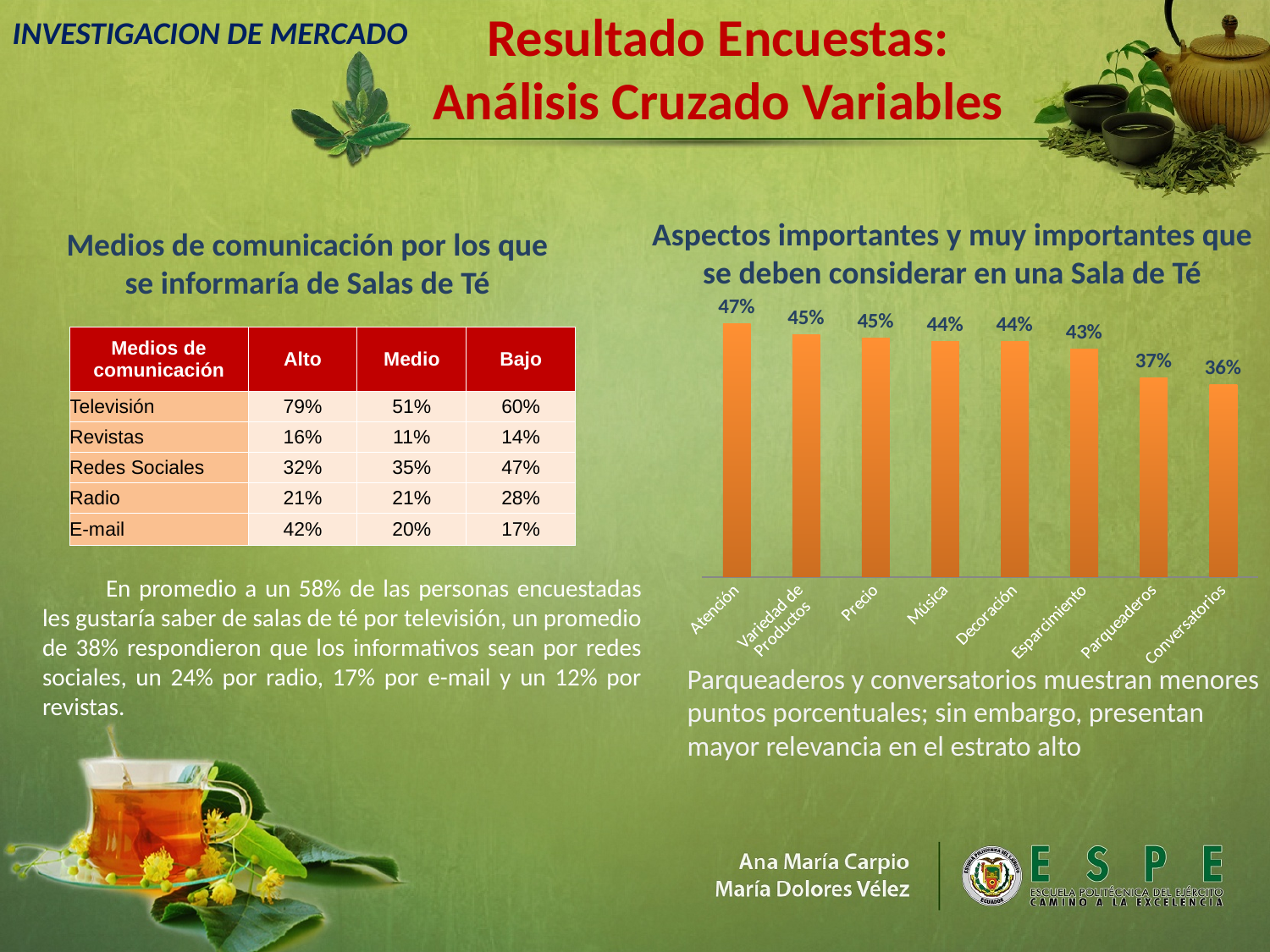
What is the value for Esparcimiento in the chart? 43% What is the value for Atención in the chart? 47% What kind of chart is shown on the slide? bar chart What is the difference between the values for Atención and Conversatorios? 11% Which category has the highest value in the chart? Atención What is the value for Parqueaderos in the chart? 37% What is the value for Conversatorios in the chart? 36% Which category has the lowest value in the chart? Conversatorios What is the title of the chart? Aspectos importantes y muy importantes que se deben considerar en una Sala de Té How many categories are shown in the chart? 8 Which is larger, the value for Música or the value for Parqueaderos? Música What is the difference between the values for Esparcimiento and Parqueaderos? 6%